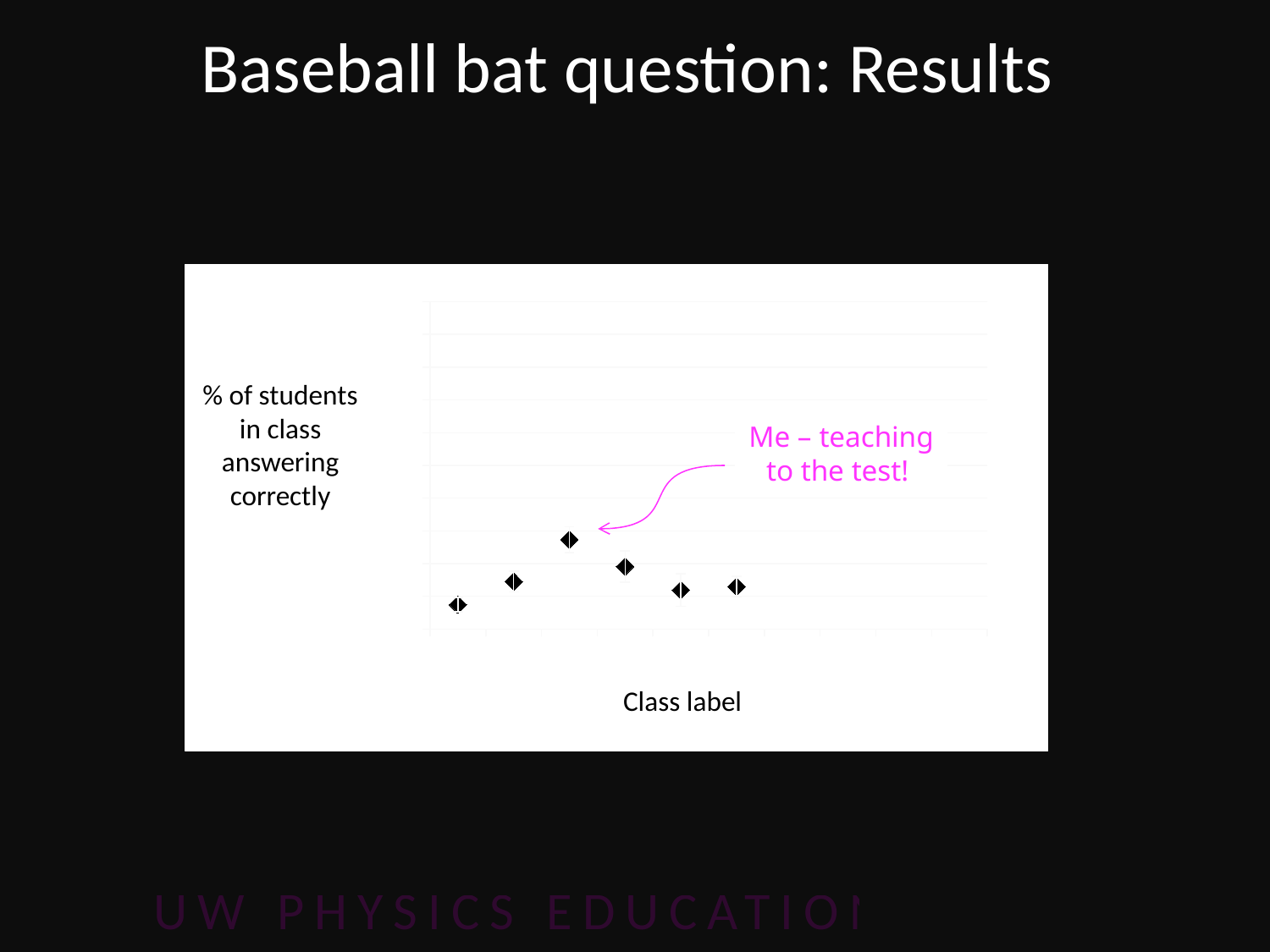
What kind of chart is shown on the slide? scatter chart Which point is higher on the chart: the second point from the left or the third point from the left? the third point from the left How many data points are plotted on the chart? 6 What is the label on the horizontal axis of the chart? Class label Which plotted point has the highest value: the leftmost point, the third point from the left, or the rightmost point? the third point from the left Which point is higher on the chart: the fourth point from the left or the fifth point from the left? the fourth point from the left Which point is higher on the chart: the leftmost point or the rightmost point? the rightmost point Which plotted point has the lowest value: the leftmost point or the rightmost point? the leftmost point What is the label on the vertical axis of the chart? % of students in class answering correctly